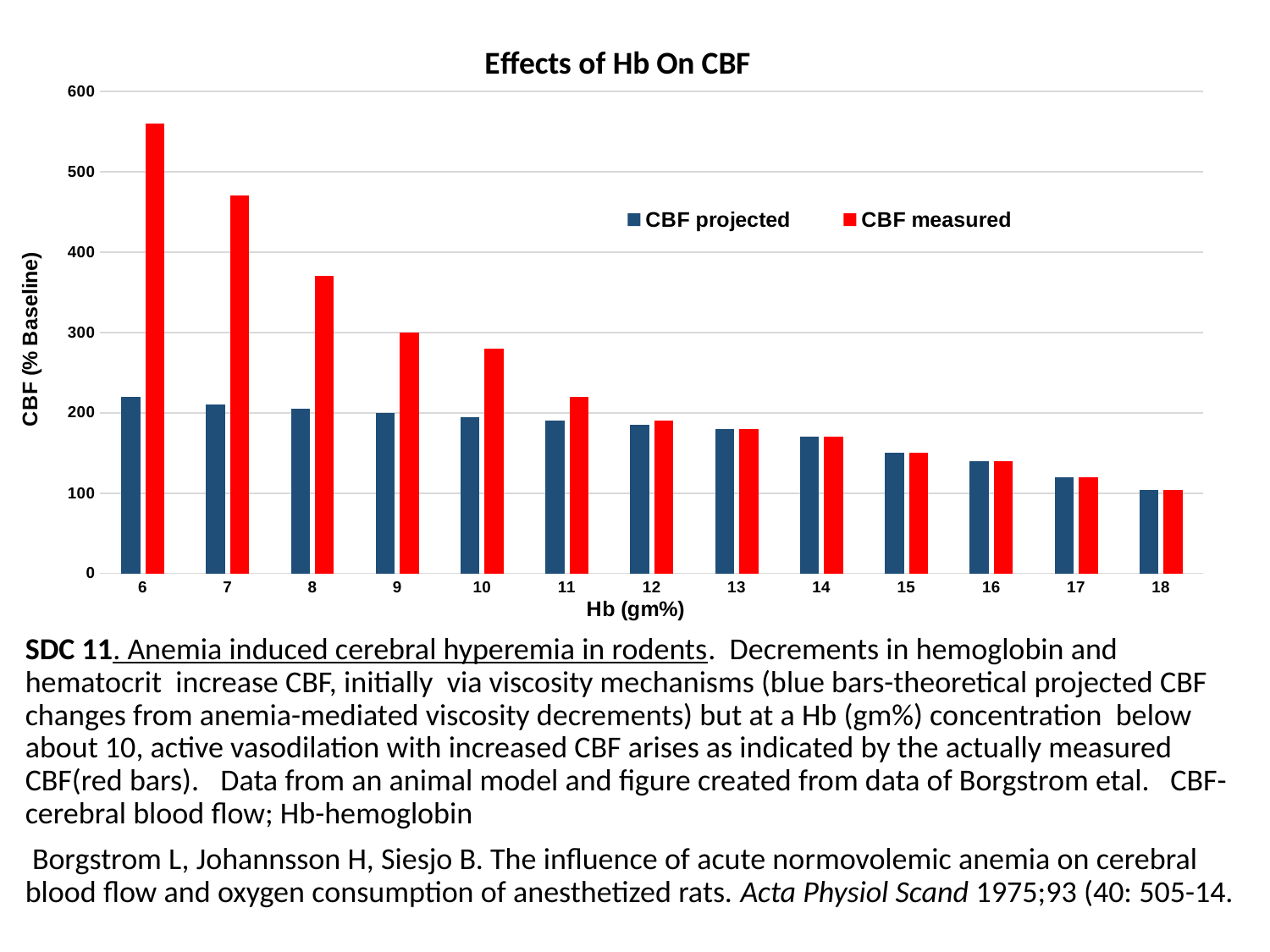
Is the CBF measured value at Hb 8 greater or less than 400? less At which Hb (gm%) value is CBF measured lowest? 18 What is the title of the chart? Effects of Hb On CBF Is the CBF measured value at Hb 6 greater or less than 500? greater At which Hb (gm%) value is CBF measured highest? 6 How many Hb (gm%) categories are plotted on the x axis? 13 At Hb 8, which is larger: CBF projected or CBF measured? CBF measured How many series does the legend list? 2 Is the CBF measured value at Hb 7 greater or less than 400? greater Do the CBF measured values rise or fall as Hb (gm%) increases along the x axis? Fall What kind of chart is shown on the slide? Bar chart